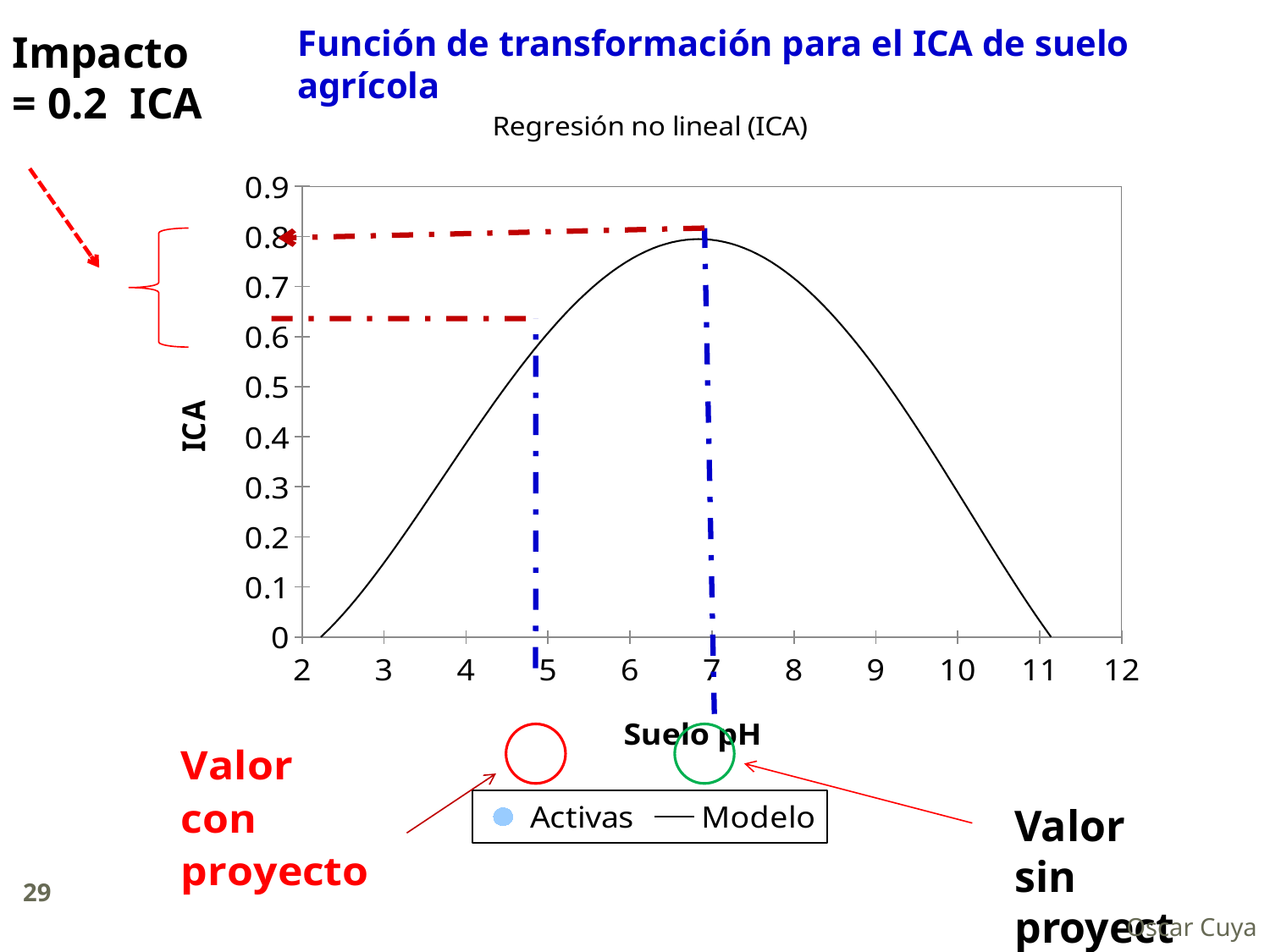
What type of chart is shown on the slide? line chart Is the value of the Modelo curve at pH 9 greater or less than 0.4? greater Is the value of the Modelo curve at pH 7 greater or less than 0.7? greater Does the Modelo curve rise or fall between pH 8 and pH 11? fall What is the title printed above the chart plot area? Regresión no lineal (ICA) Is the value of the Modelo curve at pH 4 greater or less than 0.6? less Which has the larger ICA value on the Modelo curve, pH 5 or pH 7? pH 7 Which has the larger ICA value on the Modelo curve, pH 3 or pH 9? pH 9 How does the Modelo curve behave as pH increases from 2 to 12? rises to a peak near pH 7, then falls What are the two series named in the chart legend? Activas and Modelo How many series does the legend of the chart list? 2